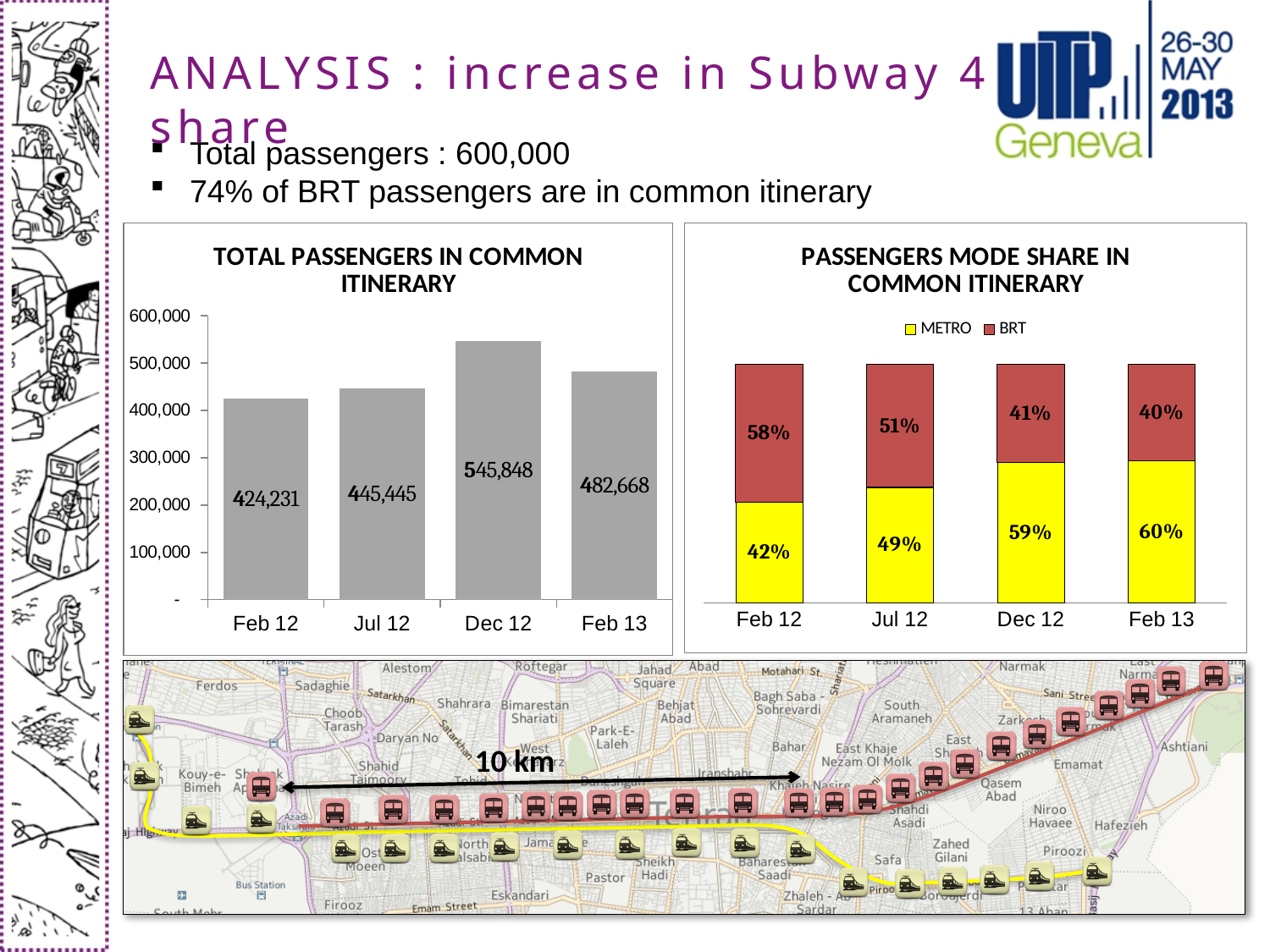
In the 'PASSENGERS MODE SHARE IN COMMON ITINERARY' chart, what is the METRO share for Feb 13? 60% In the 'TOTAL PASSENGERS IN COMMON ITINERARY' chart, what is the difference between the Dec 12 and Feb 13 values? 63,180 In the 'TOTAL PASSENGERS IN COMMON ITINERARY' chart, which period has the highest value? Dec 12 In the 'TOTAL PASSENGERS IN COMMON ITINERARY' chart, which period has the lowest value? Feb 12 In the 'PASSENGERS MODE SHARE IN COMMON ITINERARY' chart, does the METRO share rise or fall from Feb 12 to Feb 13? Rise In the 'TOTAL PASSENGERS IN COMMON ITINERARY' chart, what is the value for Dec 12? 545,848 What kind of chart is 'TOTAL PASSENGERS IN COMMON ITINERARY'? Bar chart In the 'TOTAL PASSENGERS IN COMMON ITINERARY' chart, how many periods are shown on the x axis? 4 In the 'PASSENGERS MODE SHARE IN COMMON ITINERARY' chart, what is the BRT share for Feb 12? 58% In the 'TOTAL PASSENGERS IN COMMON ITINERARY' chart, what is the value for Feb 12? 424,231 In the 'PASSENGERS MODE SHARE IN COMMON ITINERARY' chart, which series is shown in yellow? METRO In the 'PASSENGERS MODE SHARE IN COMMON ITINERARY' chart, how many series does the legend list? 2